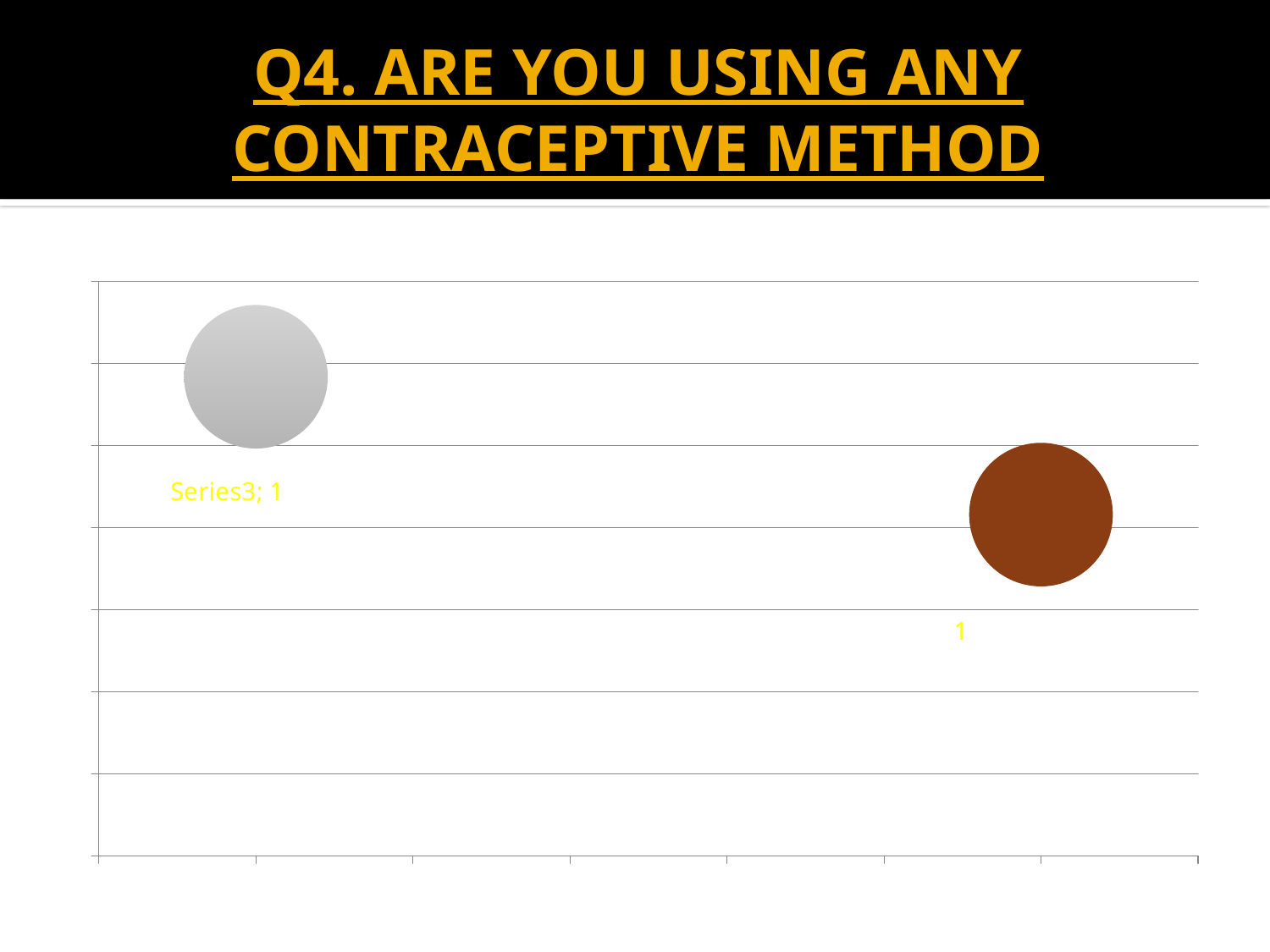
What is the title of the slide containing the chart? Q4. ARE YOU USING ANY CONTRACEPTIVE METHOD What colour is the bubble labelled Series3? gray Which bubble is positioned further to the right on the chart, the gray one or the brown one? the brown one Which bubble is positioned higher on the chart, the gray one or the brown one? the gray one What kind of chart is shown on the slide? bubble chart What value is printed in the data label for Series3? 1 How many bubbles are plotted on the chart? 2 What is the data label shown next to the gray bubble? Series3; 1 What value is printed in the data label below the brown bubble? 1